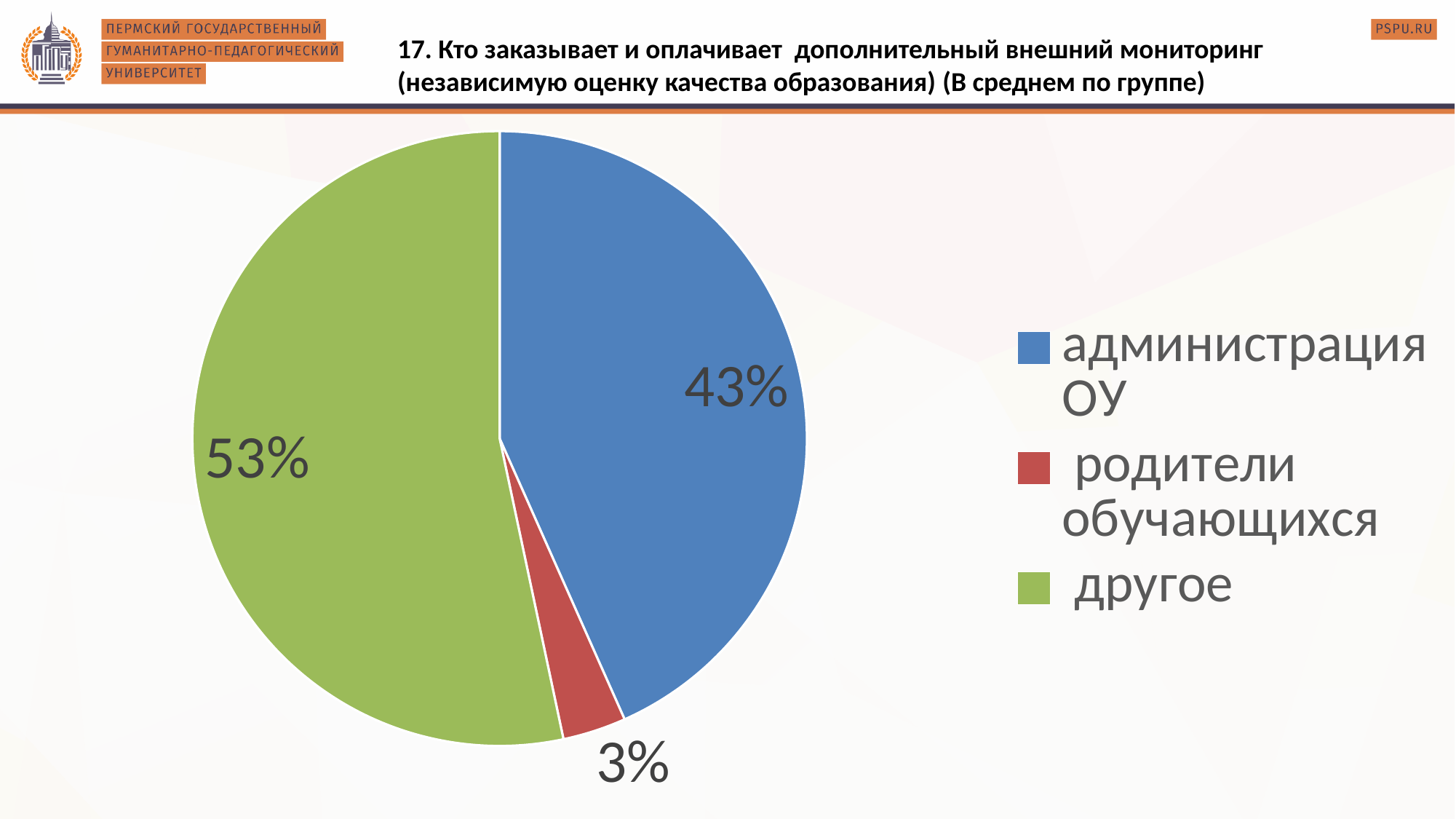
Which category has the smallest slice of the pie? родители обучающихся What share of the pie does 'родители обучающихся' hold? 3% What share of the pie does 'другое' hold? 53% Which category has the largest slice of the pie? другое What kind of chart is shown on the slide? pie chart What colour is the slice for 'родители обучающихся'? red How many slices does the pie chart have? 3 Which legend entry is shown in blue? администрация ОУ What share of the pie does 'администрация ОУ' hold? 43% Which is larger: the share for 'администрация ОУ' or the share for 'другое'? другое What is the difference in percentage points between 'другое' and 'администрация ОУ'? 10 What is the difference in percentage points between 'администрация ОУ' and 'родители обучающихся'? 40